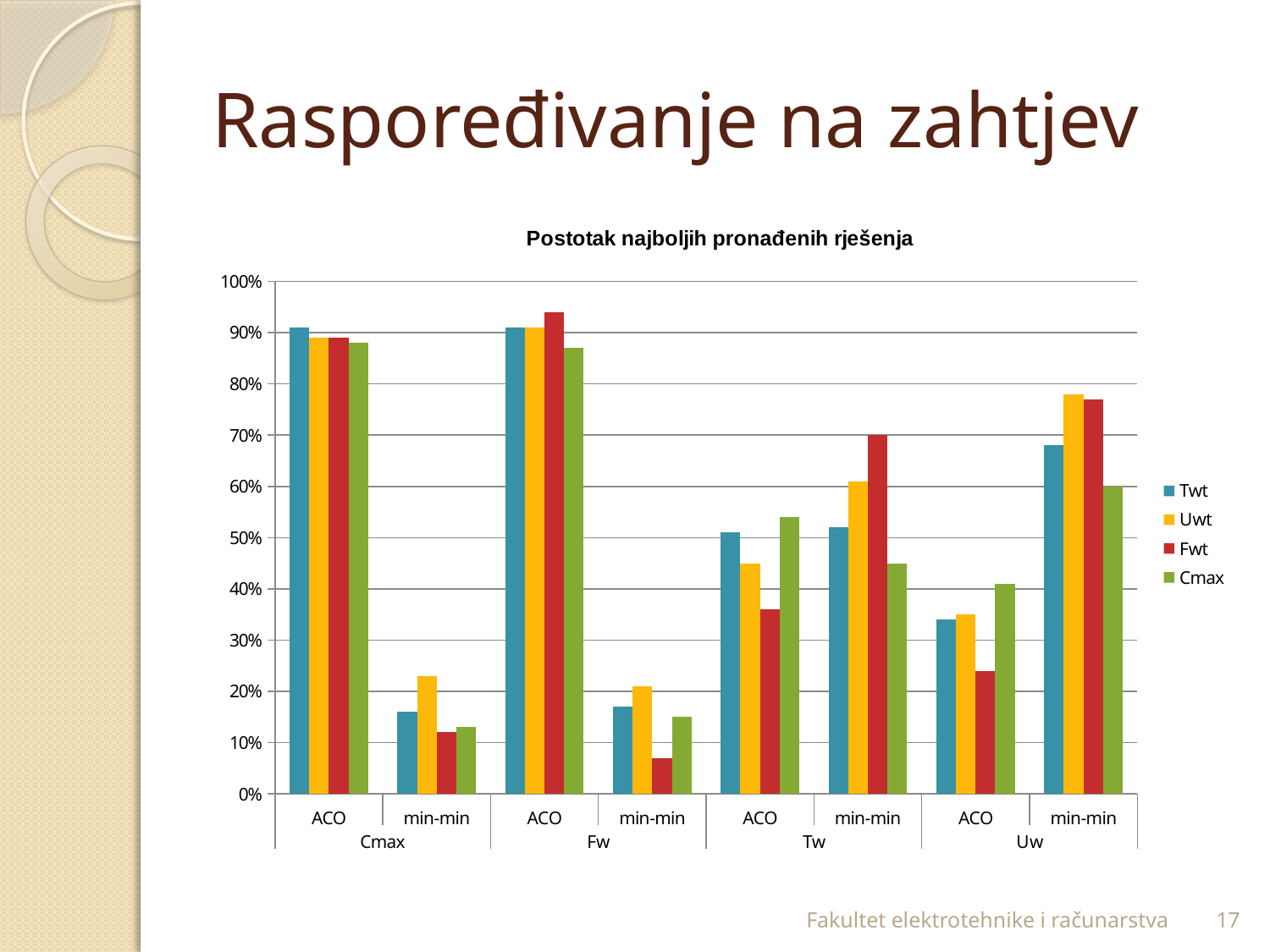
Which series are listed in the legend? Twt, Uwt, Fwt, Cmax How many category groups (ACO / min-min pairs) are shown along the x axis? 4 What kind of chart is shown on the slide? bar chart In the Fw group for min-min, which series has the lowest value? Fwt How many series does the legend list? 4 Is the Fwt value for min-min in the Fw group greater or less than 10%? less Is the Fwt value for min-min in the Tw group greater or less than 60%? greater In the Tw group for ACO, which is larger: Cmax or Fwt? Cmax In the Tw group for min-min, which series has the highest value? Fwt Is the Twt value for ACO in the Uw group greater or less than 40%? less In the Uw group for min-min, which is larger: Uwt or Cmax? Uwt What is the title of the chart? Postotak najboljih pronađenih rješenja